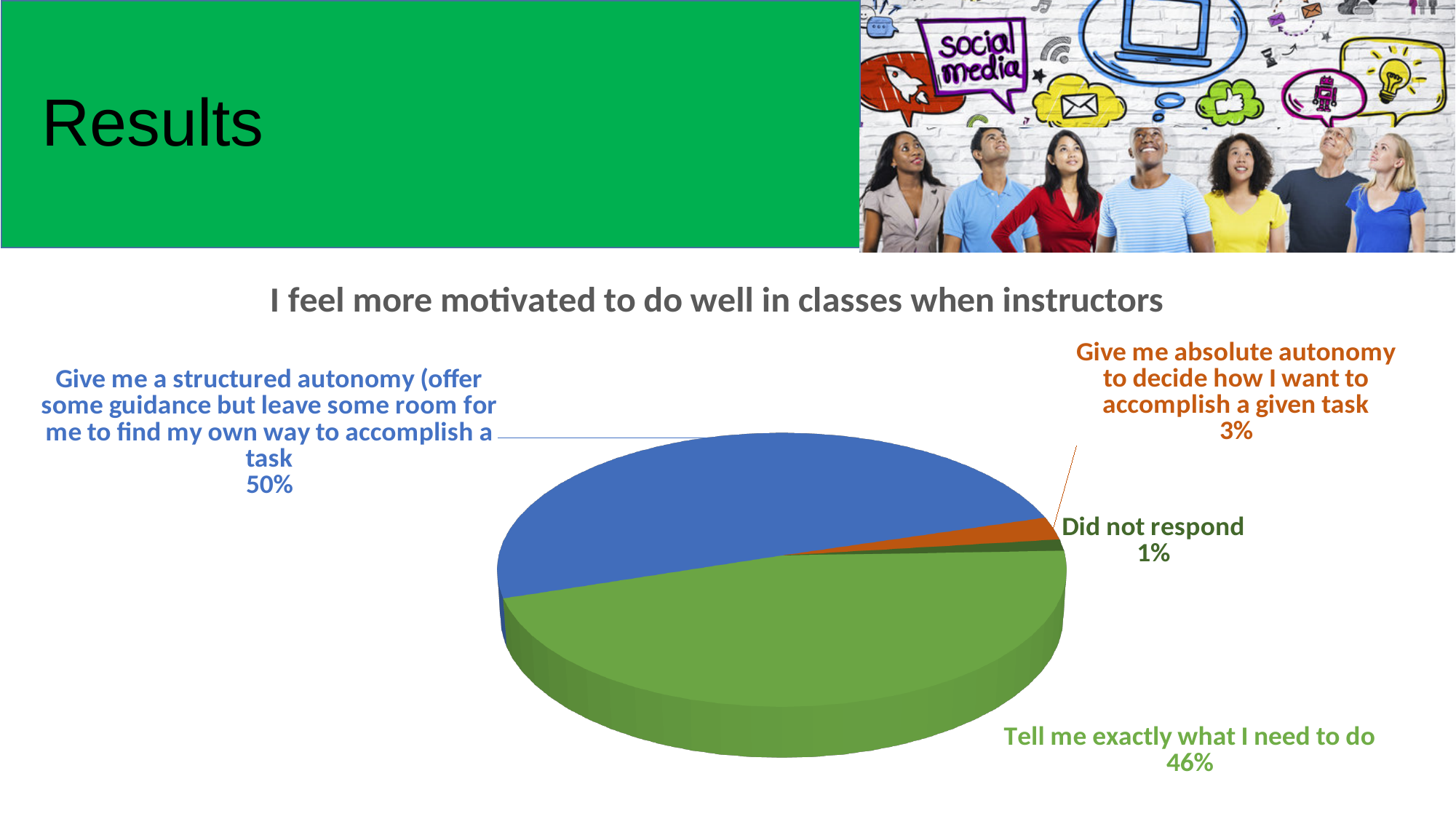
What colour is the "Tell me exactly what I need to do" slice? Green What percentage is shown for the structured autonomy slice? 50% What percentage is shown for "Did not respond"? 1% What percentage is shown for "Give me absolute autonomy to decide how I want to accomplish a given task"? 3% Which slice of the pie is the smallest? Did not respond What is the title of the chart? I feel more motivated to do well in classes when instructors What is the difference in percentage points between the structured autonomy slice and the "Tell me exactly what I need to do" slice? 4 What share of the pie is labelled "Tell me exactly what I need to do"? 46% What kind of chart is shown on the slide? Pie chart Which is larger: the "Give me absolute autonomy" slice or the "Did not respond" slice? Give me absolute autonomy to decide how I want to accomplish a given task Which slice of the pie is the largest? Give me a structured autonomy (offer some guidance but leave some room for me to find my own way to accomplish a task) How many slices does the pie chart have? 4